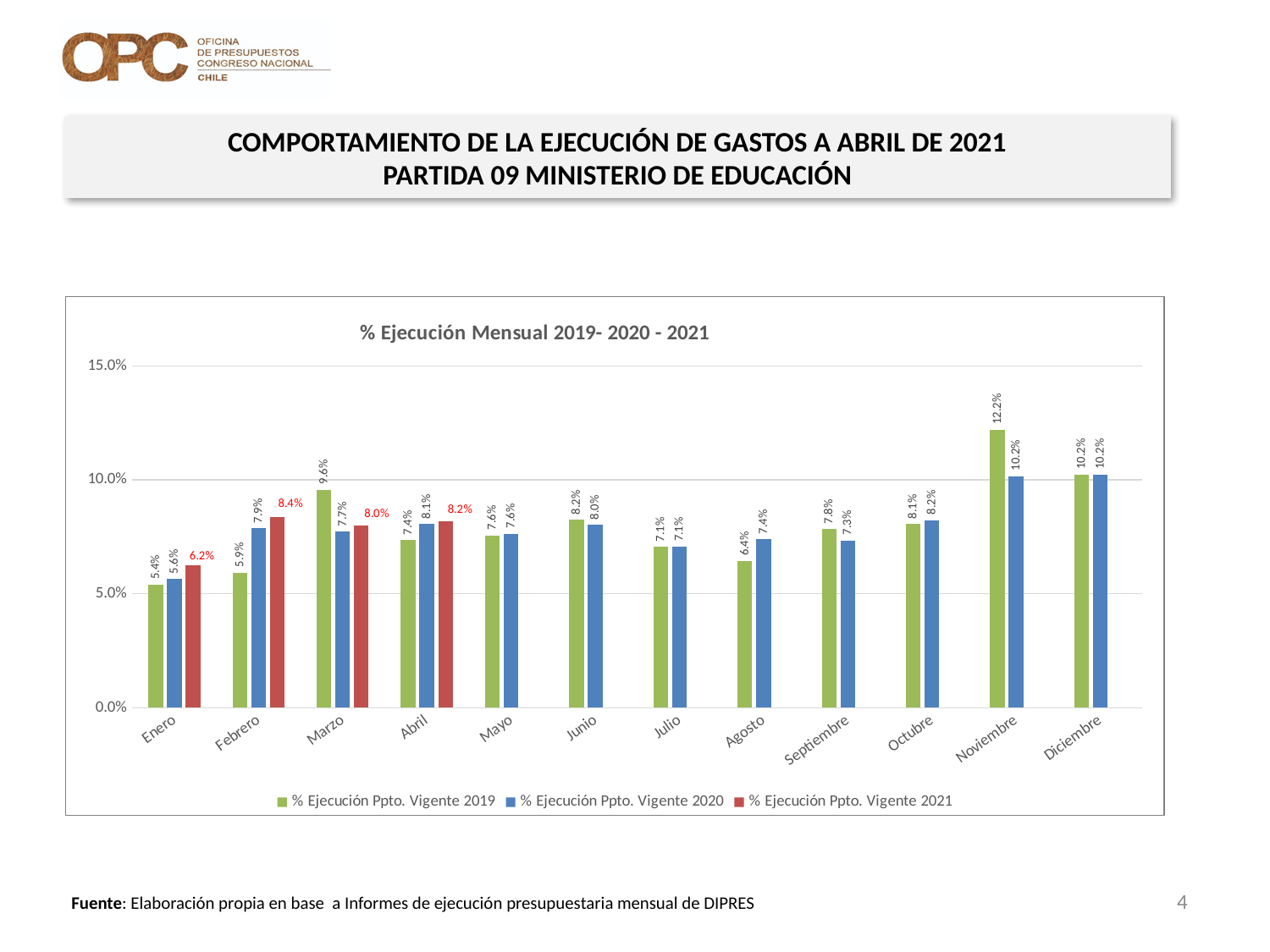
What is the value for % Ejecución Ppto. Vigente 2019 in Marzo? 9.6% Which month has the lowest value for % Ejecución Ppto. Vigente 2020? Enero What is the title of the chart? % Ejecución Mensual 2019- 2020 - 2021 How many months are shown on the x axis? 12 What is the value for % Ejecución Ppto. Vigente 2020 in Agosto? 7.4% Is the value for % Ejecución Ppto. Vigente 2019 in Noviembre greater or less than 10.0%? greater What kind of chart is shown on the slide? Bar chart Which month has the highest value for % Ejecución Ppto. Vigente 2019? Noviembre How many series does the legend list? 3 What is the difference between the 2019 and 2020 values in Noviembre? 2.0% In Febrero, which is larger: the 2019 value or the 2021 value? 2021 value (8.4%) What is the value for % Ejecución Ppto. Vigente 2021 in Abril? 8.2%